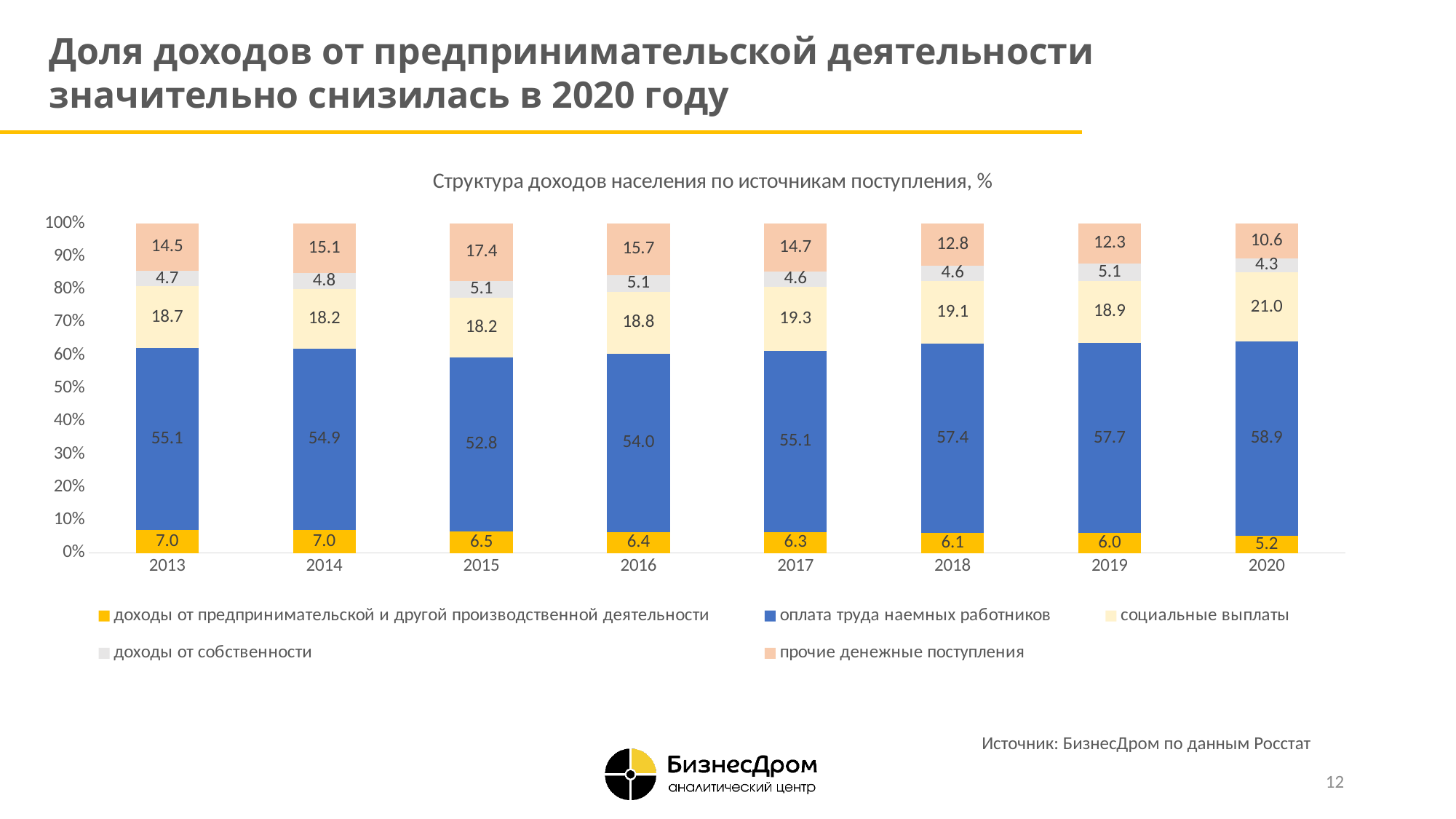
What is the value for 'оплата труда наемных работников' in 2015? 52.8 What type of chart is shown on the slide? stacked bar chart In which year is the value for 'оплата труда наемных работников' the highest? 2020 What is the value for 'доходы от предпринимательской и другой производственной деятельности' in 2020? 5.2 In which year is the value for 'прочие денежные поступления' the lowest? 2020 What is the difference between the 'доходы от предпринимательской и другой производственной деятельности' values in 2013 and 2020? 1.8 Which is larger: 'социальные выплаты' in 2016 or in 2019? 2019 How many years (categories) are shown on the x axis? 8 How many series does the legend list? 5 Does the value for 'доходы от предпринимательской и другой производственной деятельности' rise or fall from 2013 to 2020? fall What is the value for 'прочие денежные поступления' in 2014? 15.1 What is the value for 'социальные выплаты' in 2017? 19.3